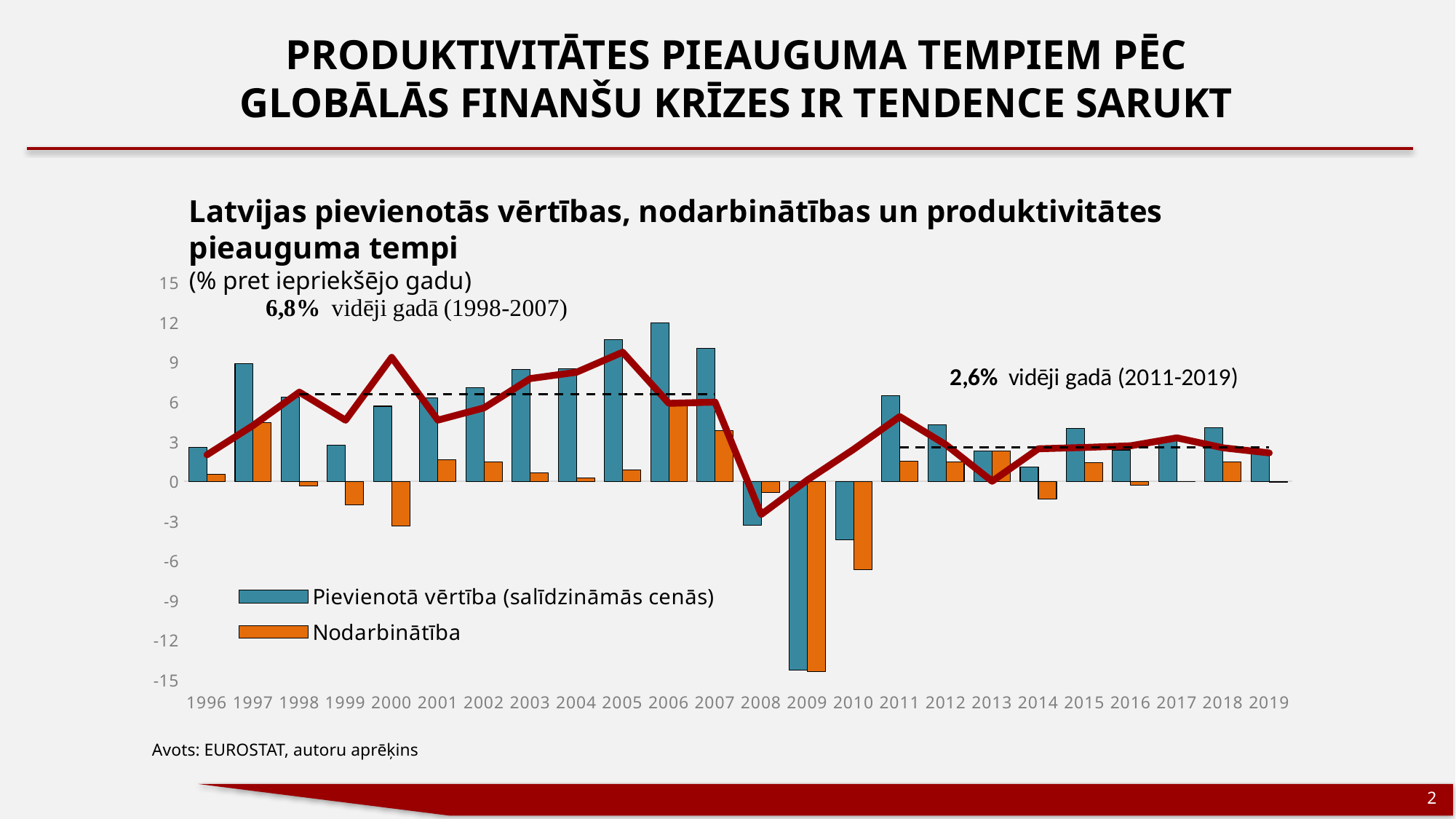
Is the Pievienotā vērtība (salīdzināmās cenās) value for 2009 greater or less than -12? less In which year is the Pievienotā vērtība (salīdzināmās cenās) bar lowest? 2009 What kind of chart is shown on the slide? bar and line chart In which year is the Pievienotā vērtība (salīdzināmās cenās) bar highest? 2006 How many series does the chart legend list? 2 Is the Pievienotā vērtība (salīdzināmās cenās) value for 2006 greater or less than 9? greater What source is cited below the chart? EUROSTAT, autoru aprēķins What average annual value is printed on the chart for the period 1998-2007? 6,8% In which year is the Nodarbinātība bar lowest? 2009 Which year has the larger Pievienotā vērtība (salīdzināmās cenās) bar, 2011 or 2012? 2011 How many years are shown on the x axis of the chart? 24 Is the Nodarbinātība value for 2010 greater or less than -3? less